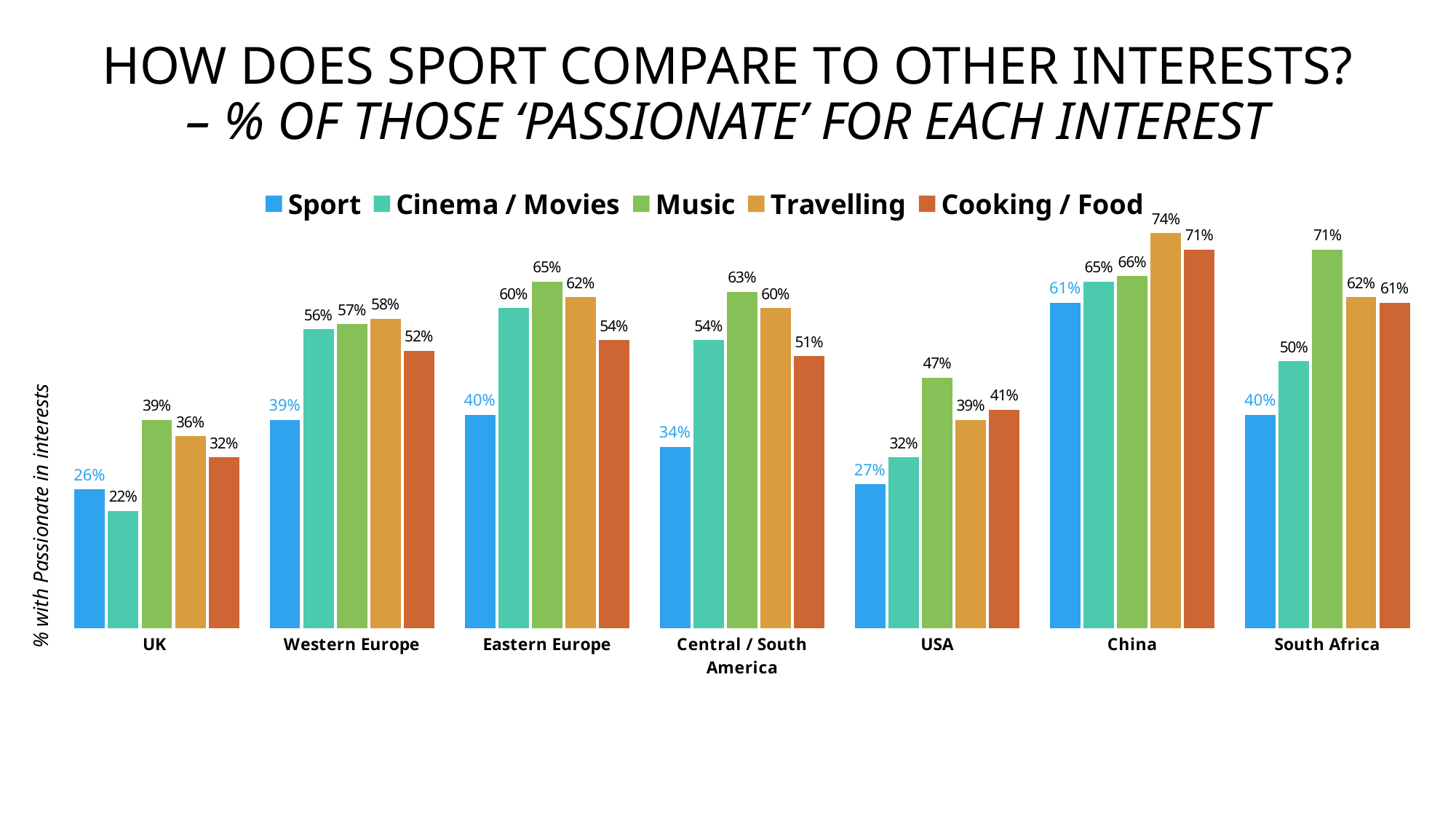
What is the value for Sport in China? 61% Which region has the lowest value for Travelling? UK How many series does the legend list? 5 How many regions are shown on the x axis? 7 Which region has the highest value for Sport? China Which is larger in the USA: Music or Cooking / Food? Music What is the value for Music in South Africa? 71% What kind of chart is shown on the slide? Bar chart Which series is shown in blue in the legend? Sport What is the value for Cinema / Movies in the UK? 22% What is the difference between Travelling and Sport in China? 13% What is the difference between Music and Cinema / Movies in South Africa? 21%